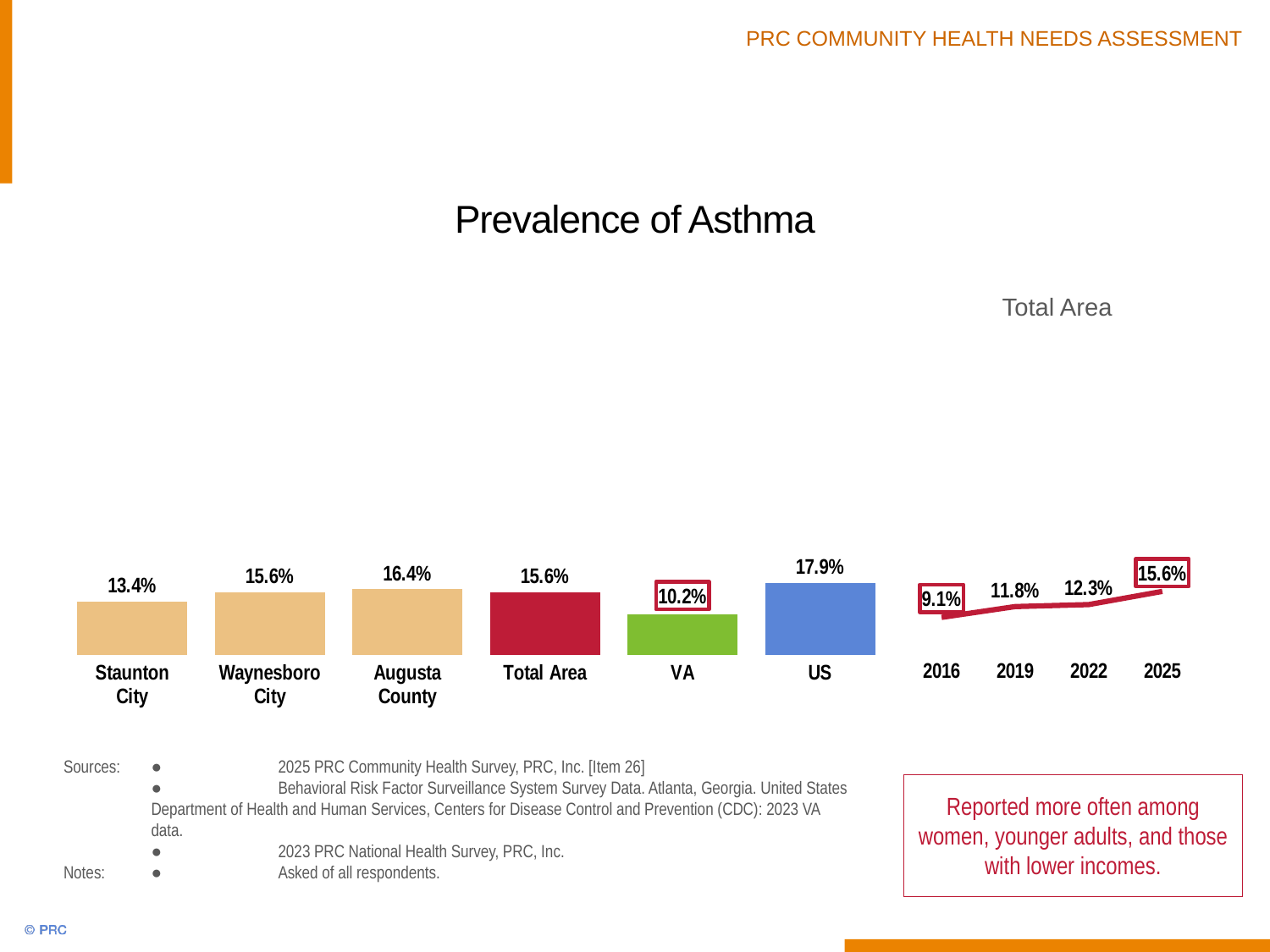
In the line chart on the right, do the values rise or fall from 2016 to 2025? rise In the bar chart, which category has the lowest prevalence of asthma? VA In the bar chart, what is the value for Augusta County? 16.4% In the line chart on the right, what was the Total Area value in 2016? 9.1% In the line chart on the right, what was the Total Area value in 2022? 12.3% In the bar chart, what is the value for VA? 10.2% In the bar chart, which is larger, the value for Augusta County or the value for Staunton City? Augusta County In the bar chart, which category has the highest prevalence of asthma? US In the bar chart, what is the prevalence of asthma for Staunton City? 13.4% In the bar chart, what is the difference between the US value and the Total Area value? 2.3% How many categories are shown in the bar chart? 6 In the line chart on the right, what is the difference between the 2025 value and the 2016 value? 6.5%